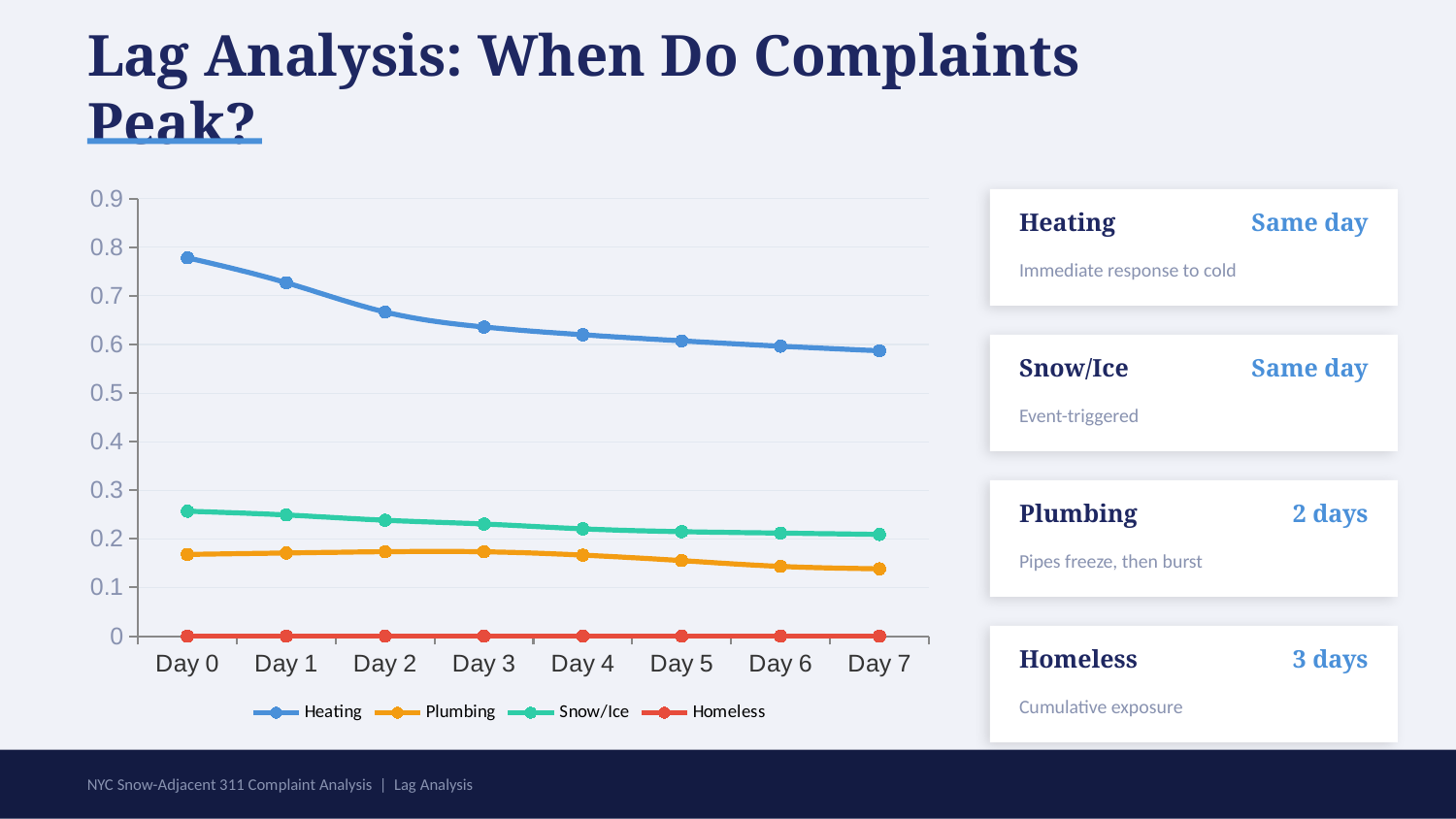
Does the Heating series rise or fall from Day 0 to Day 7? fall Is the value for Plumbing at Day 7 greater or less than 0.2? less How many series does the chart legend list? 4 What kind of chart is shown on the slide? line chart Which series has the lowest values across all days? Homeless Is the value for Heating at Day 0 greater or less than 0.7? greater At Day 0, which is larger: Snow/Ice or Plumbing? Snow/Ice Is the value for Snow/Ice at Day 0 greater or less than 0.2? greater How many days (points) are plotted along the x axis? 8 Which series has the highest value at Day 0? Heating What is the title of the slide containing the chart? Lag Analysis: When Do Complaints Peak?